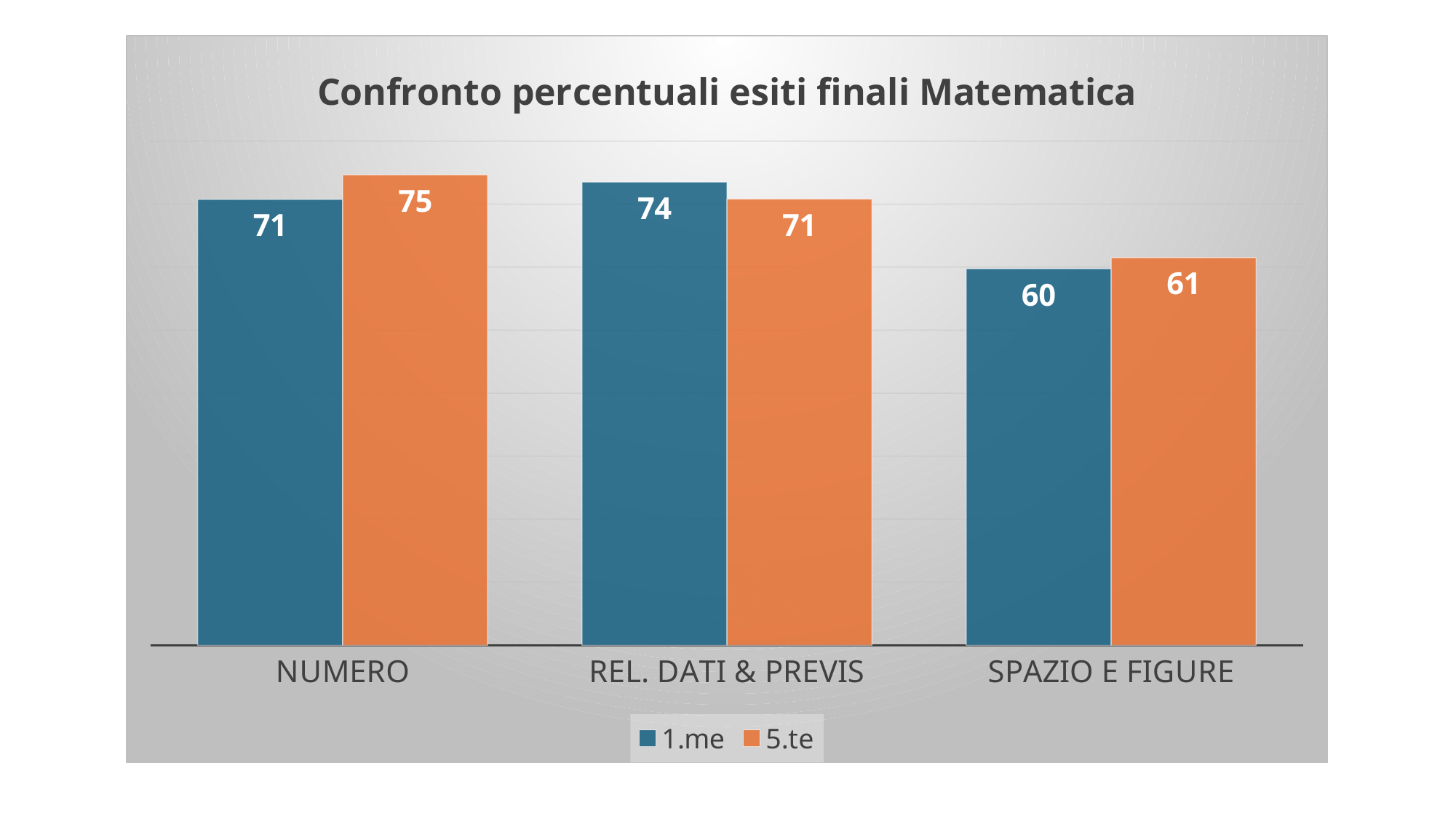
What is the value for 1.me in the NUMERO category? 71 What is the difference between the 5.te and 1.me values in the NUMERO category? 4 Which category has the lowest value for the 1.me series? SPAZIO E FIGURE What kind of chart is shown on the slide? Bar chart How many series does the legend list? 2 Which colour represents the 5.te series? Orange How many categories are shown on the x axis? 3 What is the value for 5.te in the SPAZIO E FIGURE category? 61 What is the value for 1.me in the REL. DATI & PREVIS category? 74 In the REL. DATI & PREVIS category, which series has the larger value, 1.me or 5.te? 1.me What is the title of the chart? Confronto percentuali esiti finali Matematica Which category has the highest value for the 5.te series? NUMERO